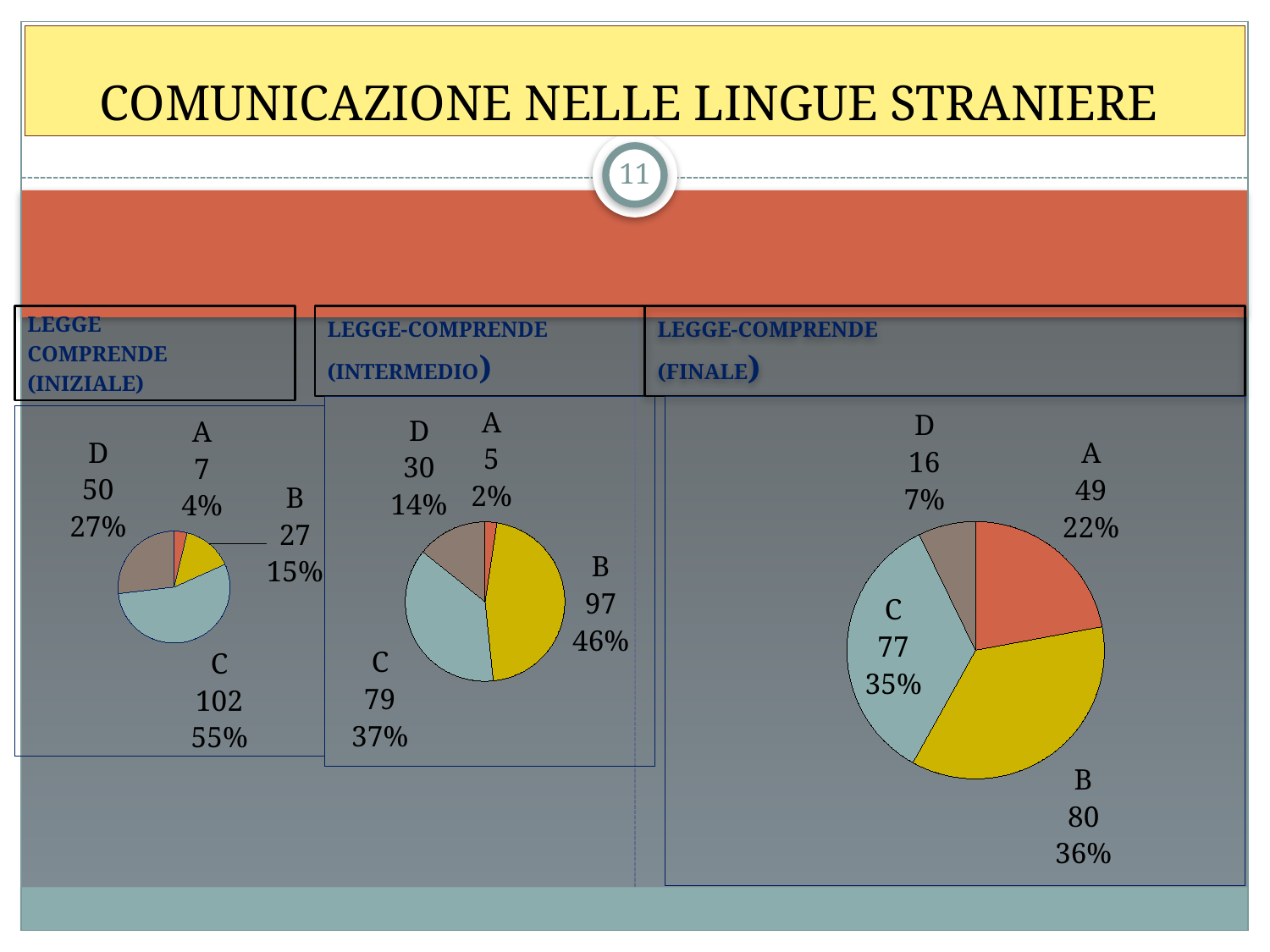
How many pie charts are shown on the slide? 3 In the LEGGE COMPRENDE (INIZIALE) pie chart, which category has the smallest value? A In the LEGGE-COMPRENDE (INTERMEDIO) pie chart, which category has the largest share? B In the LEGGE-COMPRENDE (INTERMEDIO) pie chart, what is the difference between the values for B and C? 18 In the LEGGE COMPRENDE (INIZIALE) pie chart, what value is shown for category C? 102 In the LEGGE-COMPRENDE (INTERMEDIO) pie chart, what value is shown for category B? 97 How many categories does the LEGGE-COMPRENDE (FINALE) pie chart show? 4 What type of chart is used for LEGGE COMPRENDE (INIZIALE)? Pie chart In the LEGGE COMPRENDE (INIZIALE) pie chart, what percentage share does category D have? 27% In the LEGGE-COMPRENDE (FINALE) pie chart, what value is shown for category A? 49 In the LEGGE-COMPRENDE (FINALE) pie chart, which is larger, the value for A or the value for D? A In the LEGGE-COMPRENDE (FINALE) pie chart, what percentage share does category D have? 7%